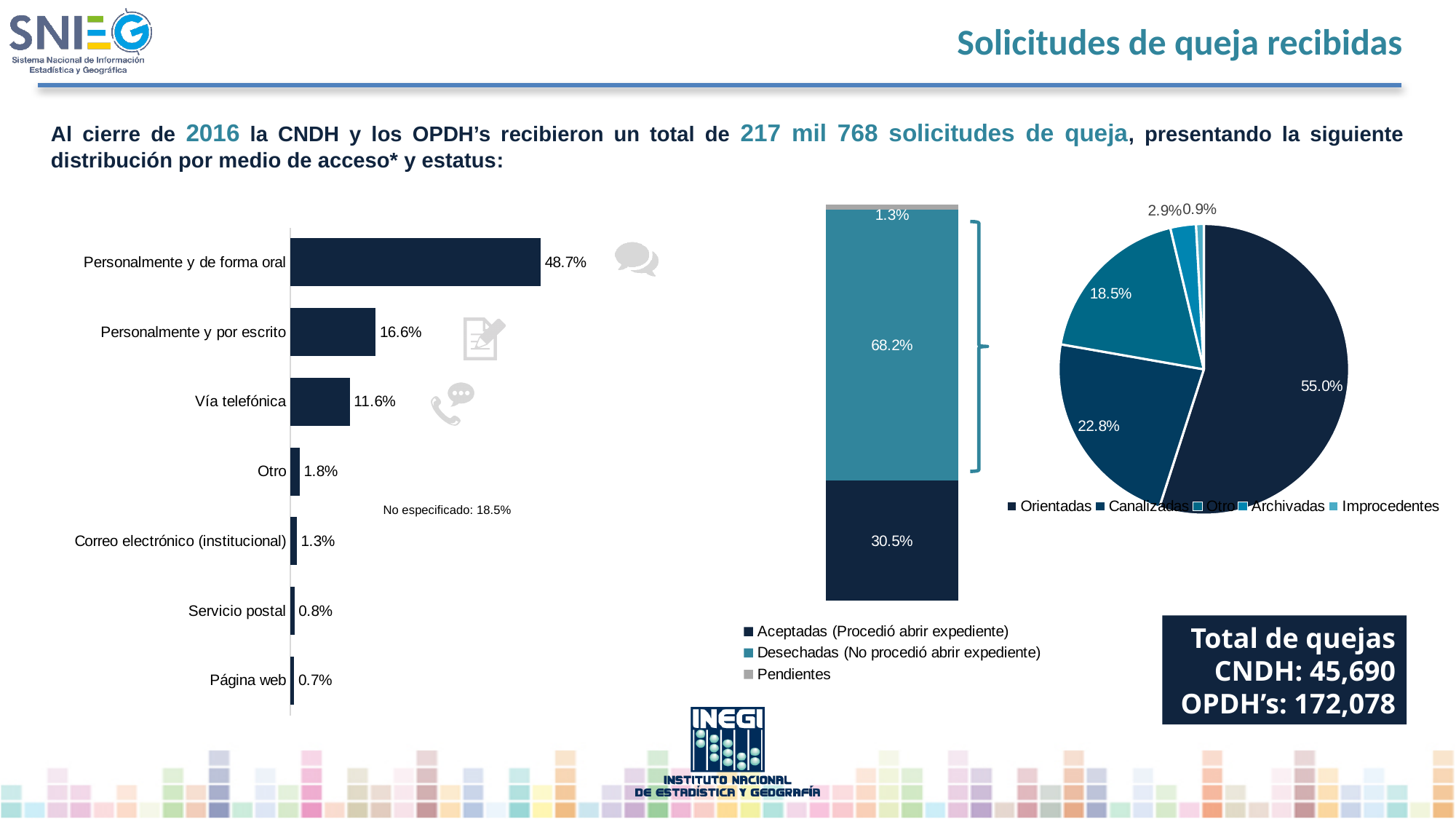
What kind of chart is the chart on the right of the slide? Pie chart In the horizontal bar chart on the left, how many categories are shown? 7 In the horizontal bar chart on the left, what is the difference between 'Personalmente y de forma oral' and 'Personalmente y por escrito'? 32.1% In the horizontal bar chart on the left, what is the value for 'Vía telefónica'? 11.6% In the pie chart on the right, which category has the smallest slice? Improcedentes In the horizontal bar chart on the left, which category has the lowest value? Página web In the stacked bar chart in the middle, what is the value for 'Pendientes'? 1.3% In the pie chart on the right, what is the share for 'Orientadas'? 55.0% In the stacked bar chart in the middle, how many series does the legend list? 3 In the horizontal bar chart on the left, which is larger: 'Otro' or 'Correo electrónico (institucional)'? Otro In the horizontal bar chart on the left, what is the value for 'Personalmente y de forma oral'? 48.7% In the stacked bar chart in the middle, what is the value for 'Desechadas (No procedió abrir expediente)'? 68.2%